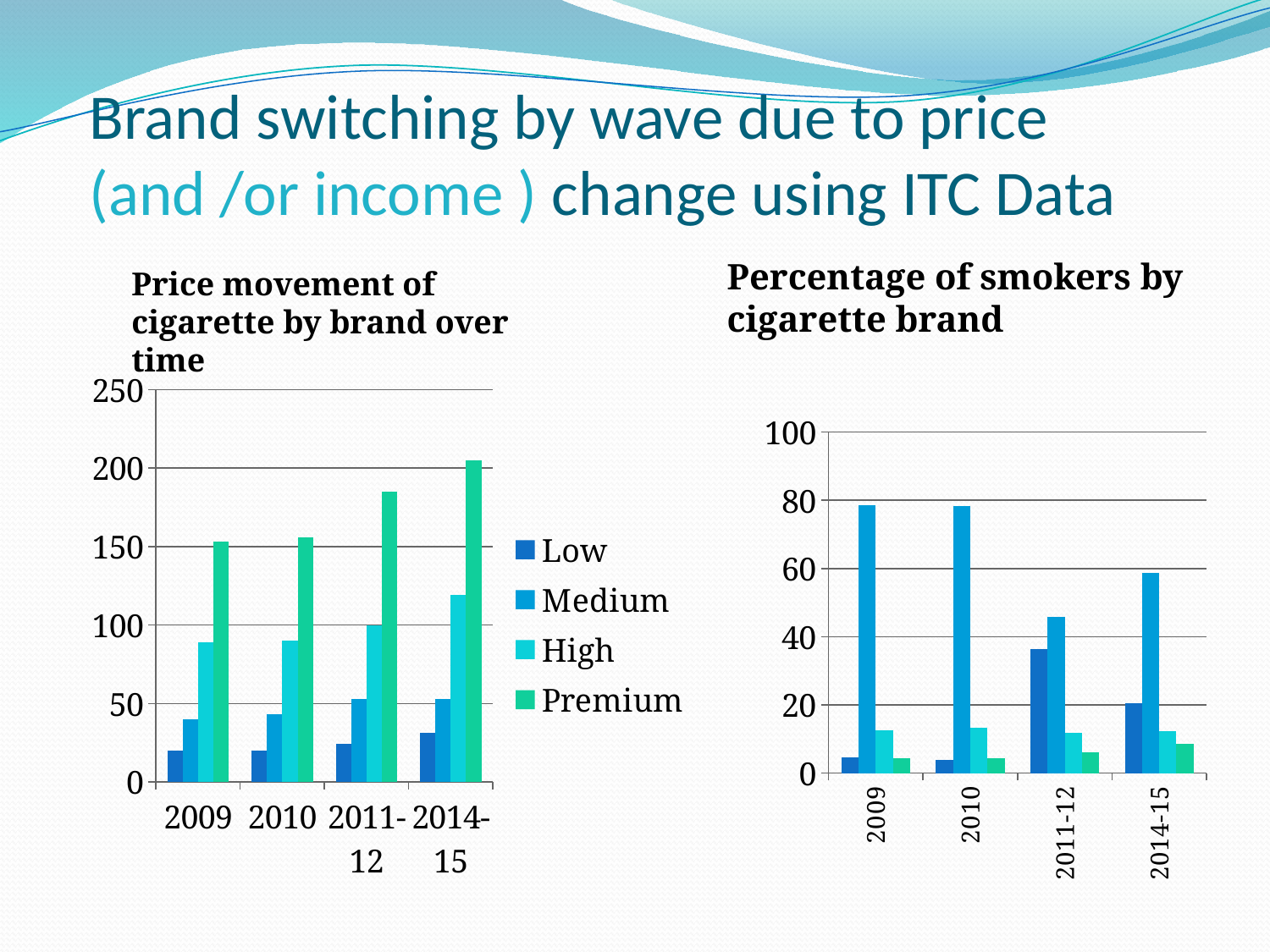
In the 'Price movement of cigarette by brand over time' chart, which series has the shortest bar in 2010? Low In the 'Percentage of smokers by cigarette brand' chart, is the tallest bar for 2009 greater or less than 60? greater What kind of chart is the 'Price movement of cigarette by brand over time' chart? bar chart How many series does the legend of the 'Price movement of cigarette by brand over time' chart list? 4 In the 'Price movement of cigarette by brand over time' chart, is the Premium value for 2014-15 greater or less than 200? greater How many categories are shown on the x axis of the 'Percentage of smokers by cigarette brand' chart? 4 In the 'Percentage of smokers by cigarette brand' chart, is the tallest bar for 2011-12 greater or less than 60? less In the 'Percentage of smokers by cigarette brand' chart, does the tallest bar in each group rise or fall from 2009 to 2014-15? fall In the 'Price movement of cigarette by brand over time' chart, does the Premium series rise or fall from 2009 to 2014-15? rise In the 'Price movement of cigarette by brand over time' chart, which series has the tallest bar in 2014-15? Premium